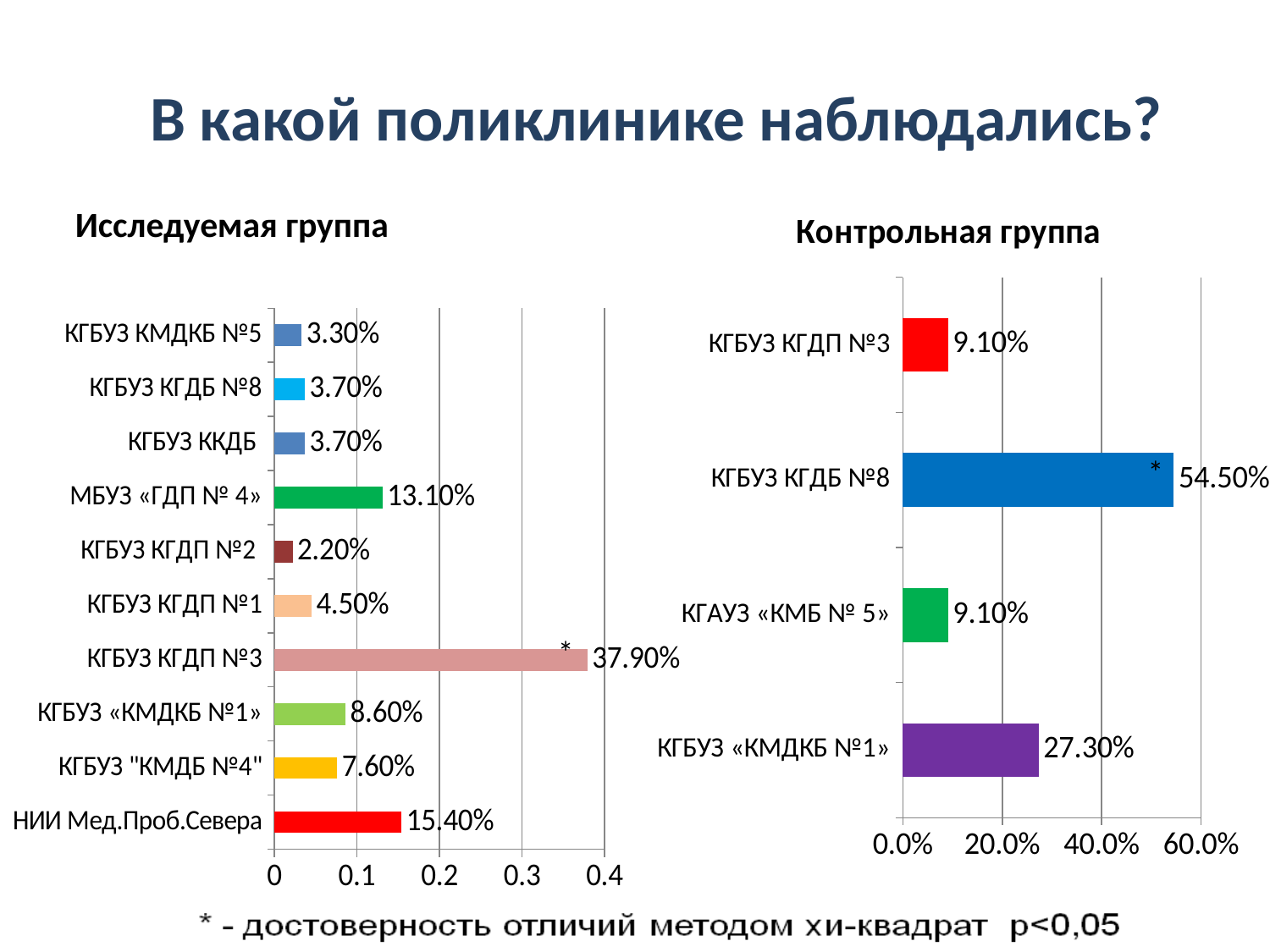
What type of chart is the Контрольная группа chart? Bar chart How many categories are shown in the Контрольная группа chart? 4 In the Контрольная группа chart, what is the difference between КГБУЗ КГДБ №8 and КГБУЗ «КМДКБ №1»? 27.20% In the Исследуемая группа chart, which category has the highest value? КГБУЗ КГДП №3 In the Исследуемая группа chart, which category has the lowest value? КГБУЗ КГДП №2 In the Исследуемая группа chart, which is larger: КГБУЗ «КМДКБ №1» or КГБУЗ "КМДБ №4"? КГБУЗ «КМДКБ №1» In the Исследуемая группа chart, what is the difference between НИИ Мед.Проб.Севера and МБУЗ «ГДП № 4»? 2.30% How many categories are shown in the Исследуемая группа chart? 10 In the Контрольная группа chart, which category has the highest value? КГБУЗ КГДБ №8 In the Исследуемая группа chart, what is the value for НИИ Мед.Проб.Севера? 15.40% In the Контрольная группа chart, what is the value for КГБУЗ «КМДКБ №1»? 27.30% In the Исследуемая группа chart, what is the value for КГБУЗ КГДП №3? 37.90%